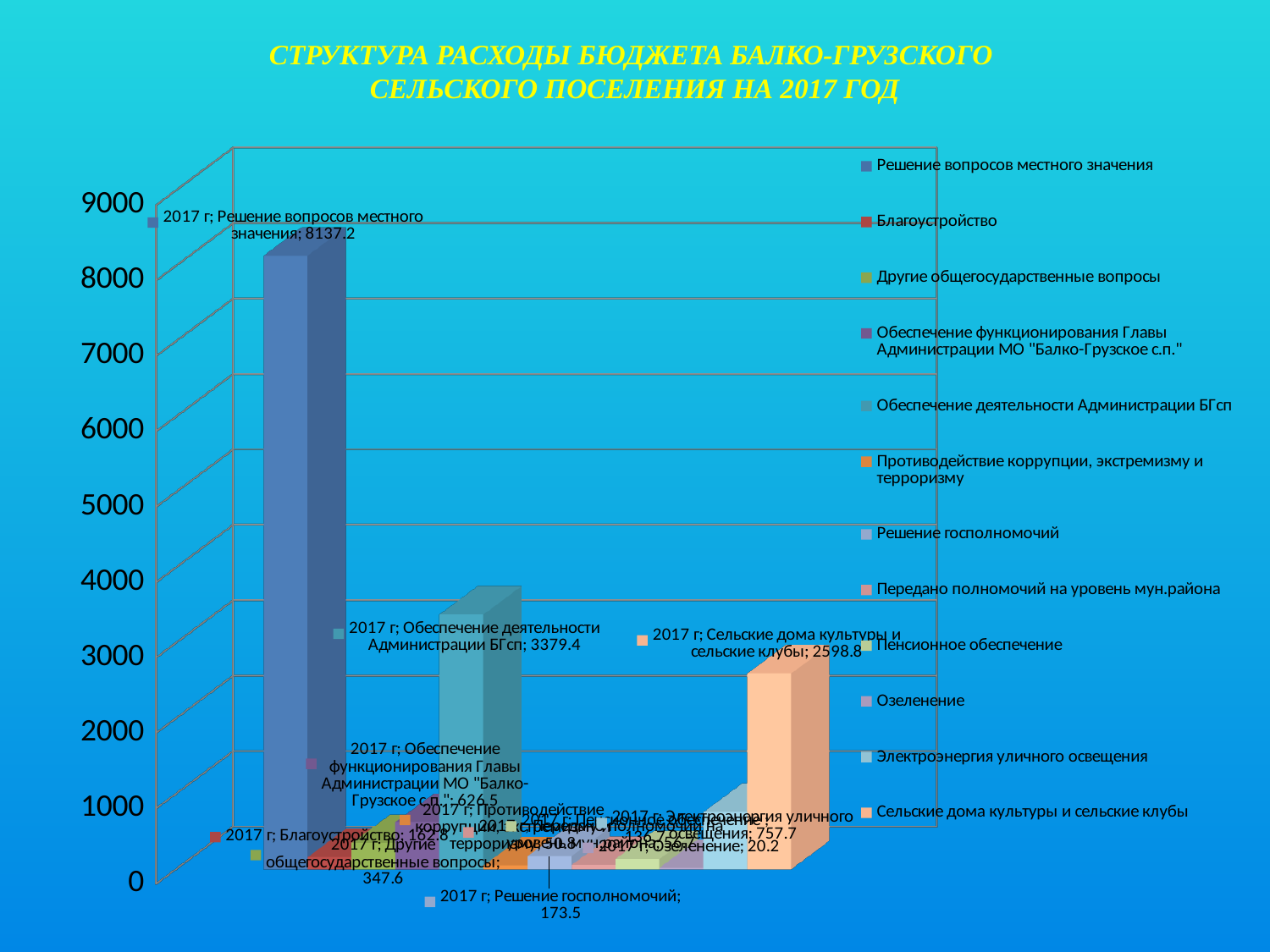
What is the value for Решение вопросов местного значения? 8137.2 What kind of chart is shown on the slide? bar chart What is the value for Обеспечение деятельности Администрации БГсп? 3379.4 How many series does the legend list? 12 What is the value for Решение госполномочий? 173.5 What is the value for Сельские дома культуры и сельские клубы? 2598.8 What is the value for Электроэнергия уличного освещения? 757.7 Is the value for Решение вопросов местного значения greater or less than 8000? greater What is the value for Другие общегосударственные вопросы? 347.6 What is the difference between Решение вопросов местного значения and Обеспечение деятельности Администрации БГсп? 4757.8 Which series has the highest value? Решение вопросов местного значения Which is larger, Обеспечение деятельности Администрации БГсп or Сельские дома культуры и сельские клубы? Обеспечение деятельности Администрации БГсп